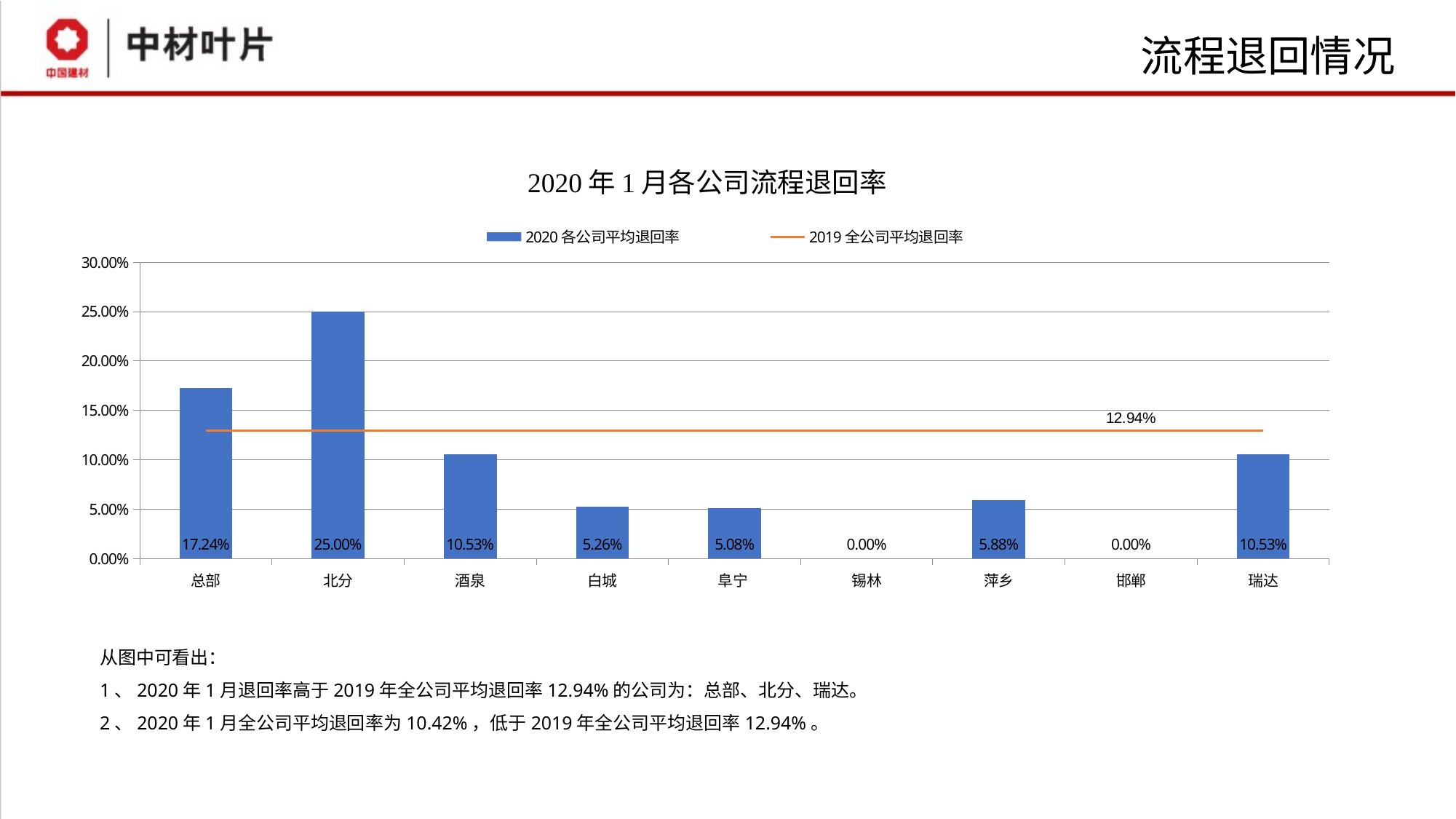
Which companies have a 2020 各公司平均退回率 of 0.00%? 锡林 and 邯郸 Which has a higher 2020 退回率, 白城 or 萍乡? 萍乡 What is the 2019 全公司平均退回率 shown by the orange line? 12.94% What is the title of the chart? 2020年1月各公司流程退回率 What is the difference between the 2020 退回率 of 北分 and 总部? 7.76% What is the 2020 各公司平均退回率 value for 北分? 25.00% How many series does the legend list? 2 Which company has the highest 2020 各公司平均退回率? 北分 What kind of chart is used to show the 2020 各公司平均退回率 values? bar chart How many companies are shown on the x axis? 9 Is the 2020 退回率 for 酒泉 greater or less than 15.00%? less What is the 2020 各公司平均退回率 value for 总部? 17.24%